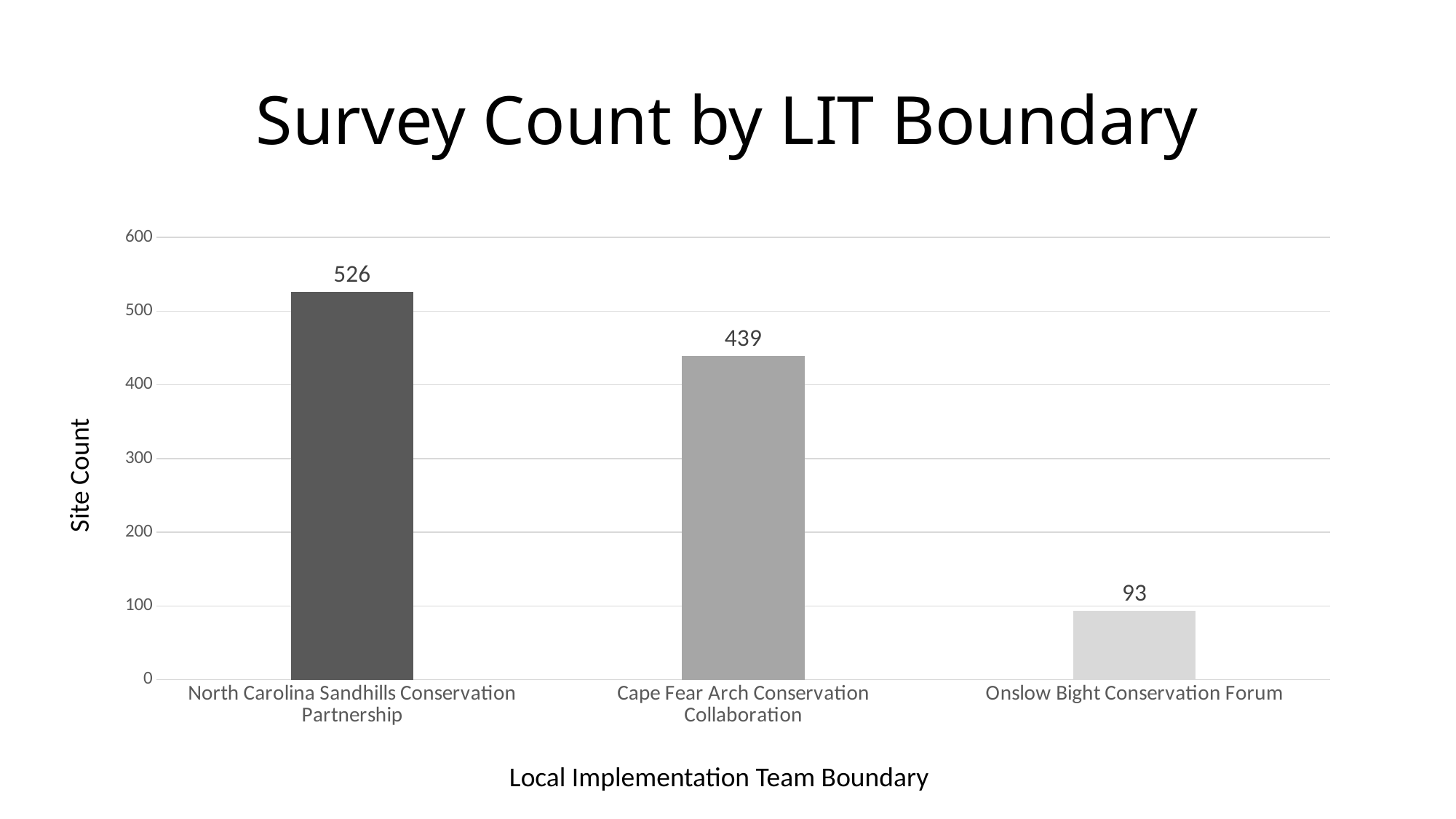
What kind of chart is shown on the slide? bar chart What is the title of the chart? Survey Count by LIT Boundary Which has a larger site count, Cape Fear Arch Conservation Collaboration or Onslow Bight Conservation Forum? Cape Fear Arch Conservation Collaboration Is the value for Onslow Bight Conservation Forum greater or less than 100? less How many LIT boundaries are shown in the chart? 3 What is the difference in site count between North Carolina Sandhills Conservation Partnership and Cape Fear Arch Conservation Collaboration? 87 What is the site count for Onslow Bight Conservation Forum? 93 Which LIT boundary has the highest site count? North Carolina Sandhills Conservation Partnership What is the site count for North Carolina Sandhills Conservation Partnership? 526 Which LIT boundary has the lowest site count? Onslow Bight Conservation Forum What is the difference in site count between Cape Fear Arch Conservation Collaboration and Onslow Bight Conservation Forum? 346 What is the site count for Cape Fear Arch Conservation Collaboration? 439